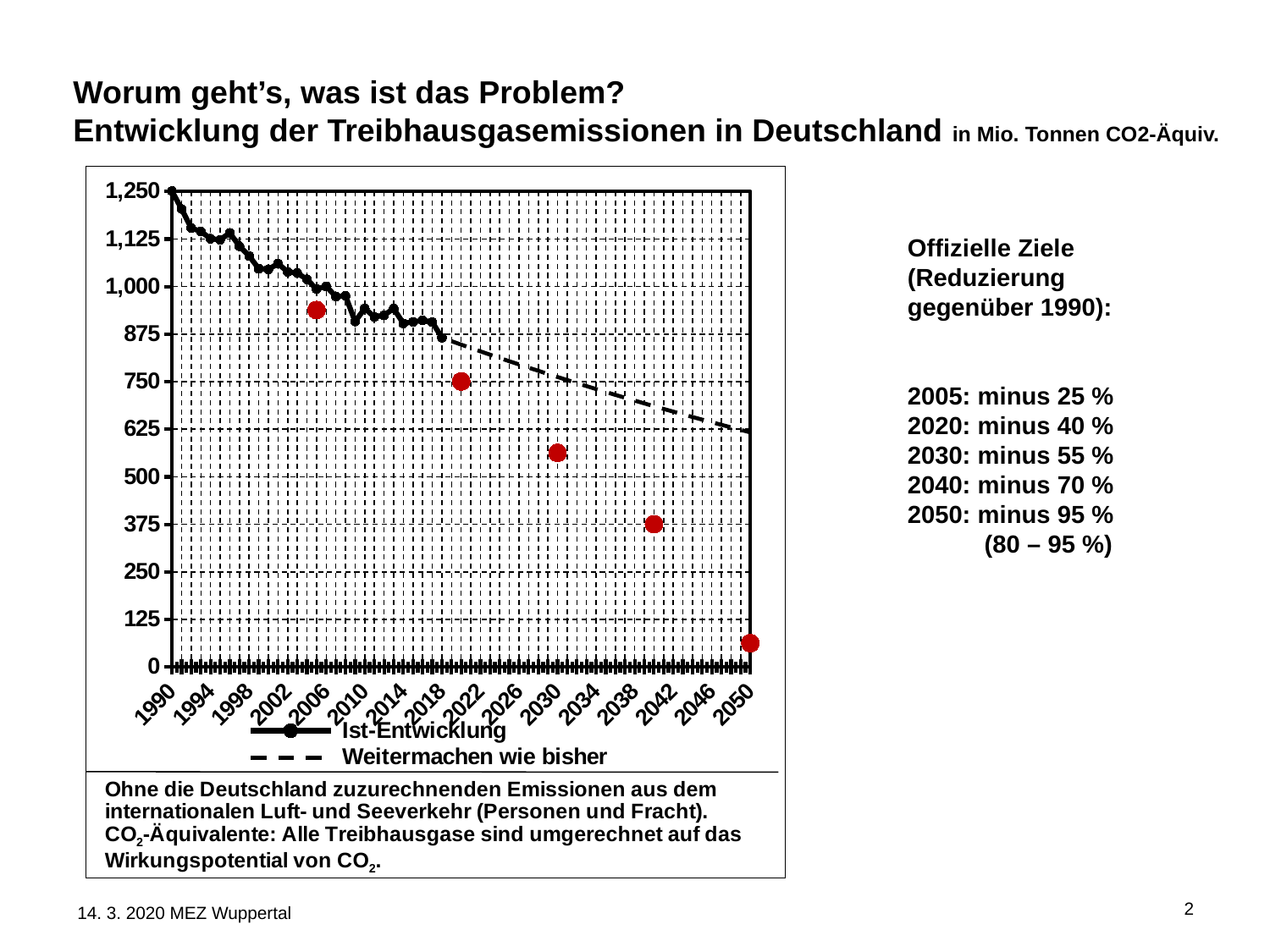
What is the value of the Ist-Entwicklung line in 1990? 1,250 Is the Weitermachen wie bisher value for 2040 greater or less than 750? less What is the highest tick value shown on the y axis? 1,250 What are the two entries in the chart legend? Ist-Entwicklung and Weitermachen wie bisher Is the Ist-Entwicklung value for 2010 greater or less than 1,000? less At what value is the red target dot for 2020 placed? 750 Does the Ist-Entwicklung line rise or fall from 1990 to 2018? fall At what value is the red target dot for 2040 placed? 375 What kind of chart is shown on the slide? line chart How many series does the chart legend list? 2 Which is larger, the Ist-Entwicklung value in 1990 or in 2018? 1990 Is the Ist-Entwicklung value for 2010 greater or less than 875? greater